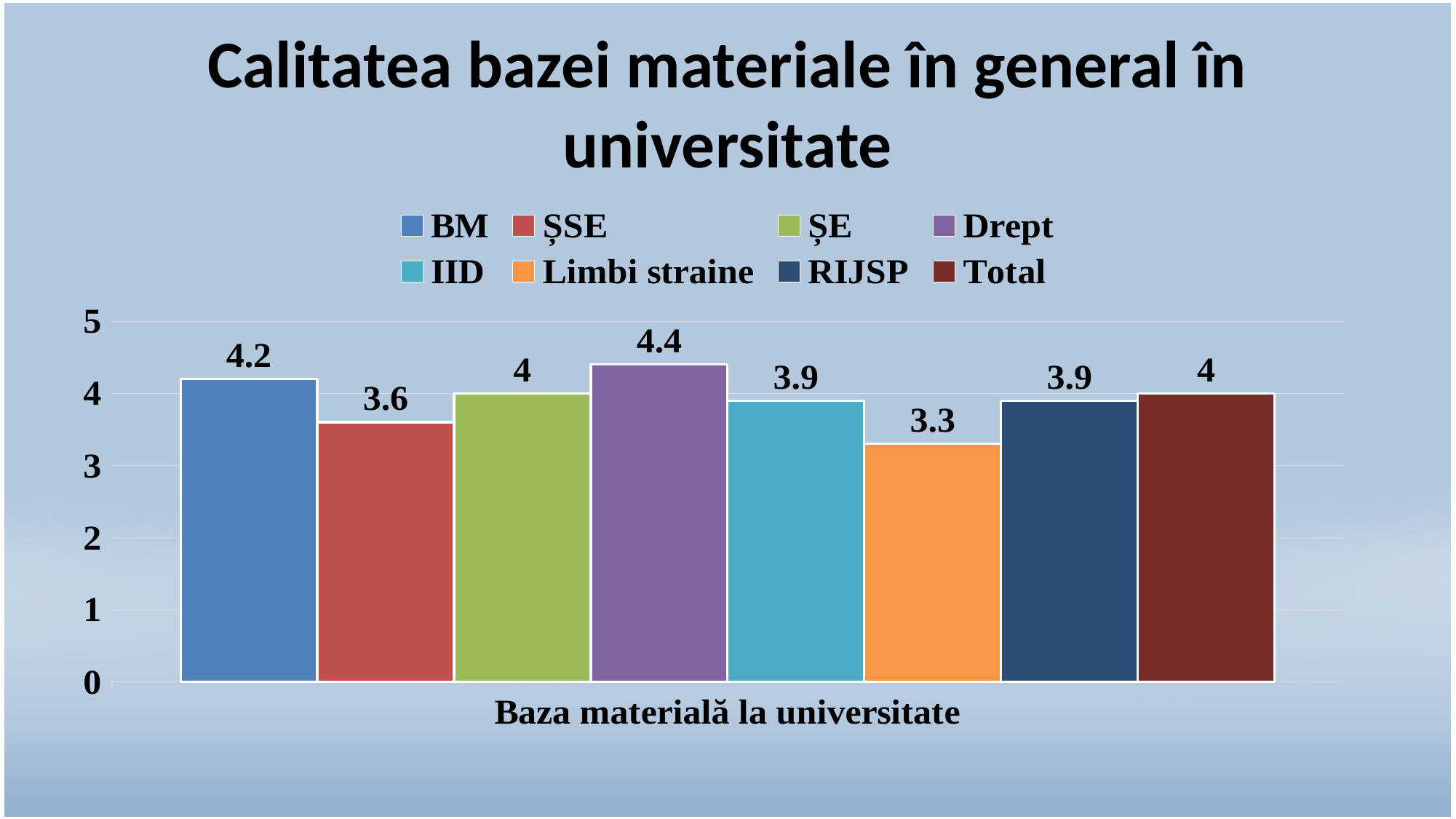
Which series has the lowest value? Limbi straine What is the value for Drept? 4.4 Which series has the highest value? Drept What kind of chart is shown on the slide? Bar chart What is the value for Limbi straine? 3.3 How many series does the legend list? 8 What is the value for BM? 4.2 What is the value for Total? 4 What is the difference between the values for Drept and ȘSE? 0.8 Which is larger, the value for BM or the value for IID? BM What is the title of the chart? Calitatea bazei materiale în general în universitate What is the label on the horizontal axis? Baza materială la universitate